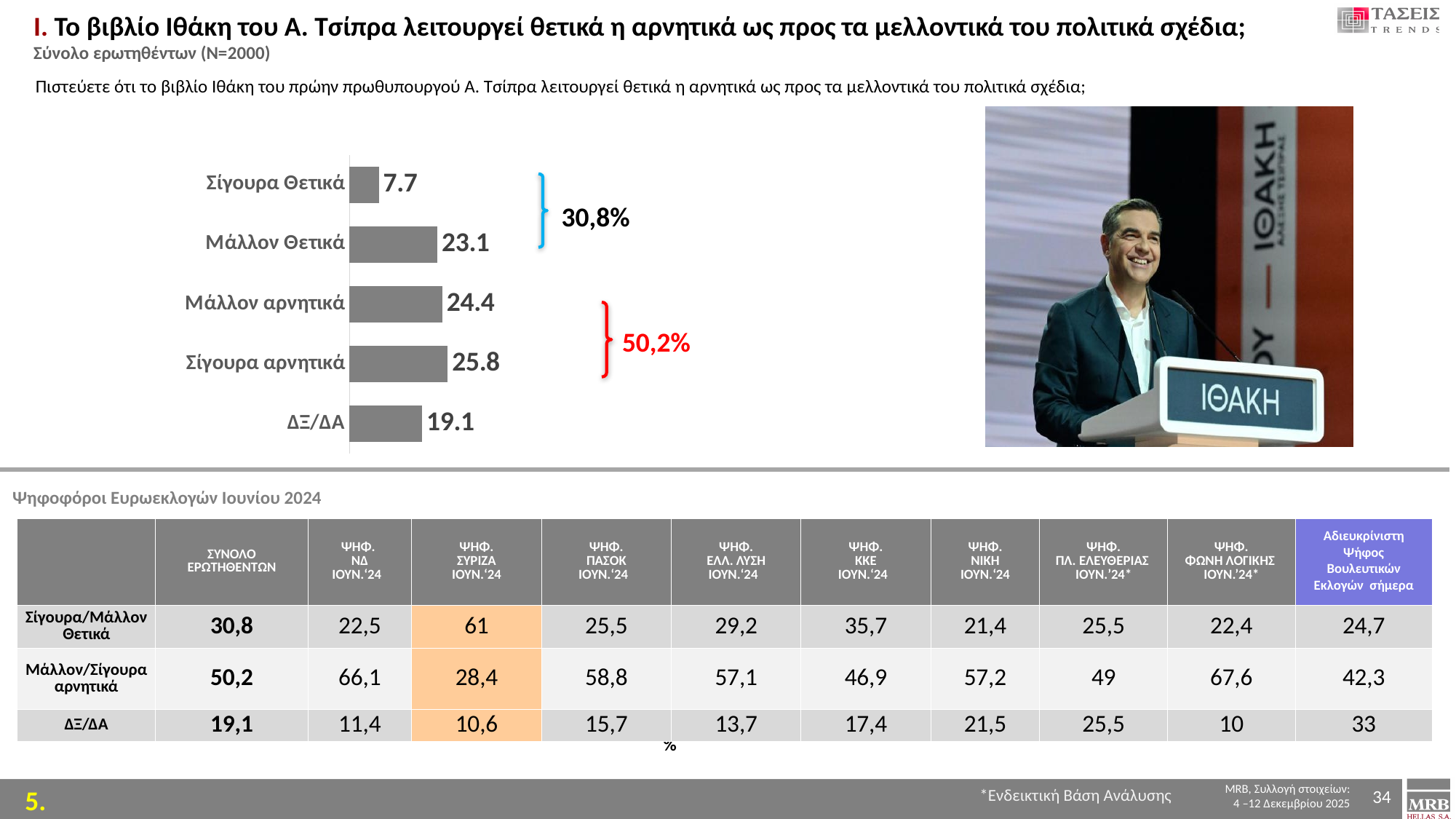
Which category has the lowest value in the bar chart? Σίγουρα Θετικά Which category has the highest value in the bar chart? Σίγουρα αρνητικά What is the difference between the values for "Σίγουρα αρνητικά" and "Σίγουρα Θετικά" in the bar chart? 18.1 What value is shown for "Σίγουρα Θετικά" in the bar chart? 7.7 What combined percentage is annotated next to the two positive bars ("Σίγουρα Θετικά" and "Μάλλον Θετικά") in the bar chart? 30,8% What value is shown for "ΔΞ/ΔΑ" in the bar chart? 19.1 What combined percentage is annotated in red next to the two negative bars in the bar chart? 50,2% What value is shown for "Μάλλον Θετικά" in the bar chart? 23.1 Which is larger in the bar chart: the value for "Μάλλον Θετικά" or the value for "ΔΞ/ΔΑ"? Μάλλον Θετικά What value is shown for "Σίγουρα αρνητικά" in the bar chart? 25.8 What kind of chart is shown on the slide? Bar chart How many categories are shown in the bar chart? 5